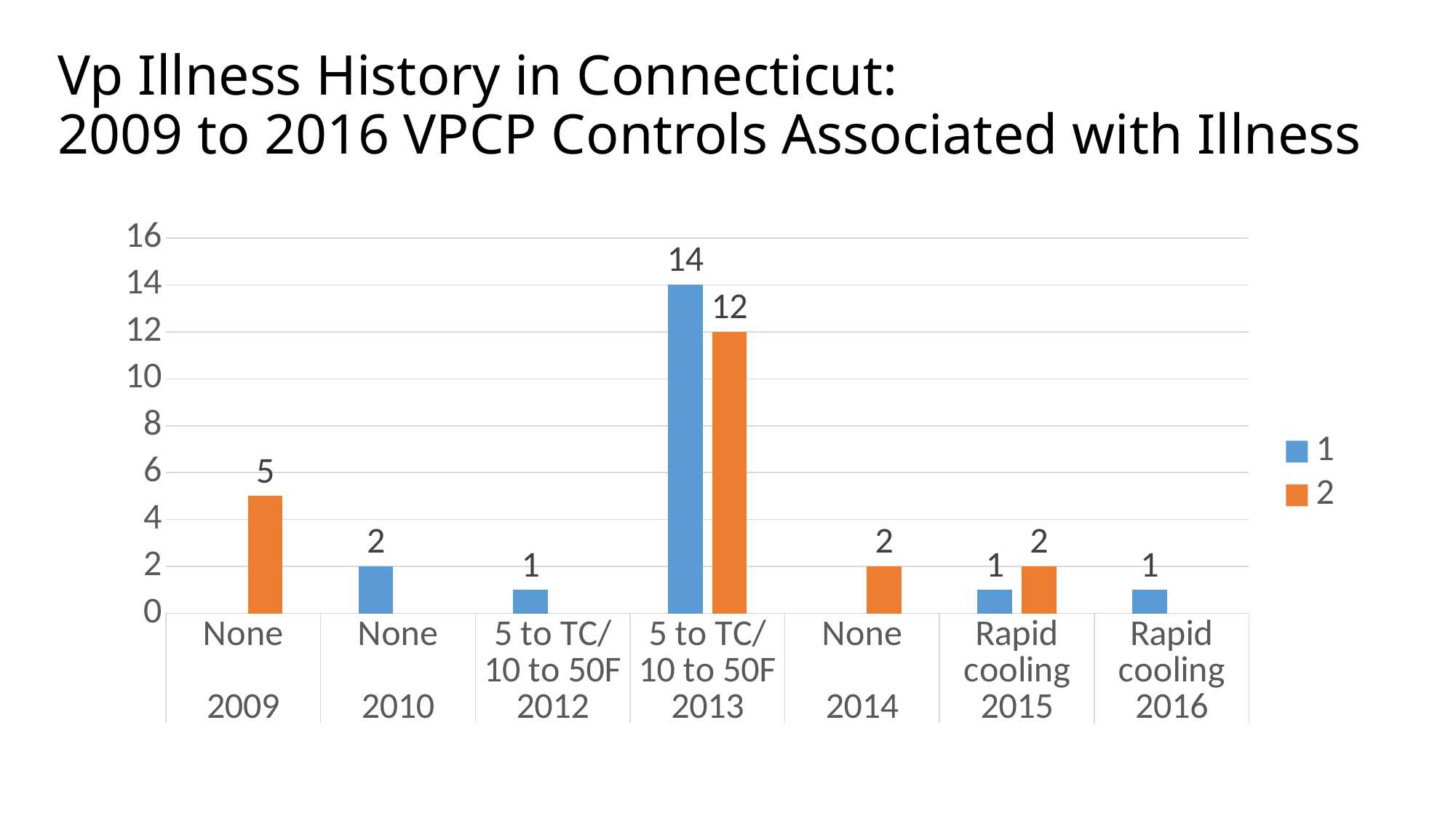
Which year has the highest value for series 1? 2013 What is the value of series 1 for 2010? 2 What is the value of series 2 for 2009? 5 What is the value of series 1 for 2013? 14 How many series does the legend list? 2 What is the value of series 2 for 2013? 12 How many year categories are shown on the x axis? 7 Which year has the highest value for series 2? 2013 What is the difference between series 1 and series 2 for 2013? 2 What kind of chart is shown on the slide? bar chart What control is listed for 2015 and 2016? Rapid cooling Which is larger for 2013, series 1 or series 2? series 1